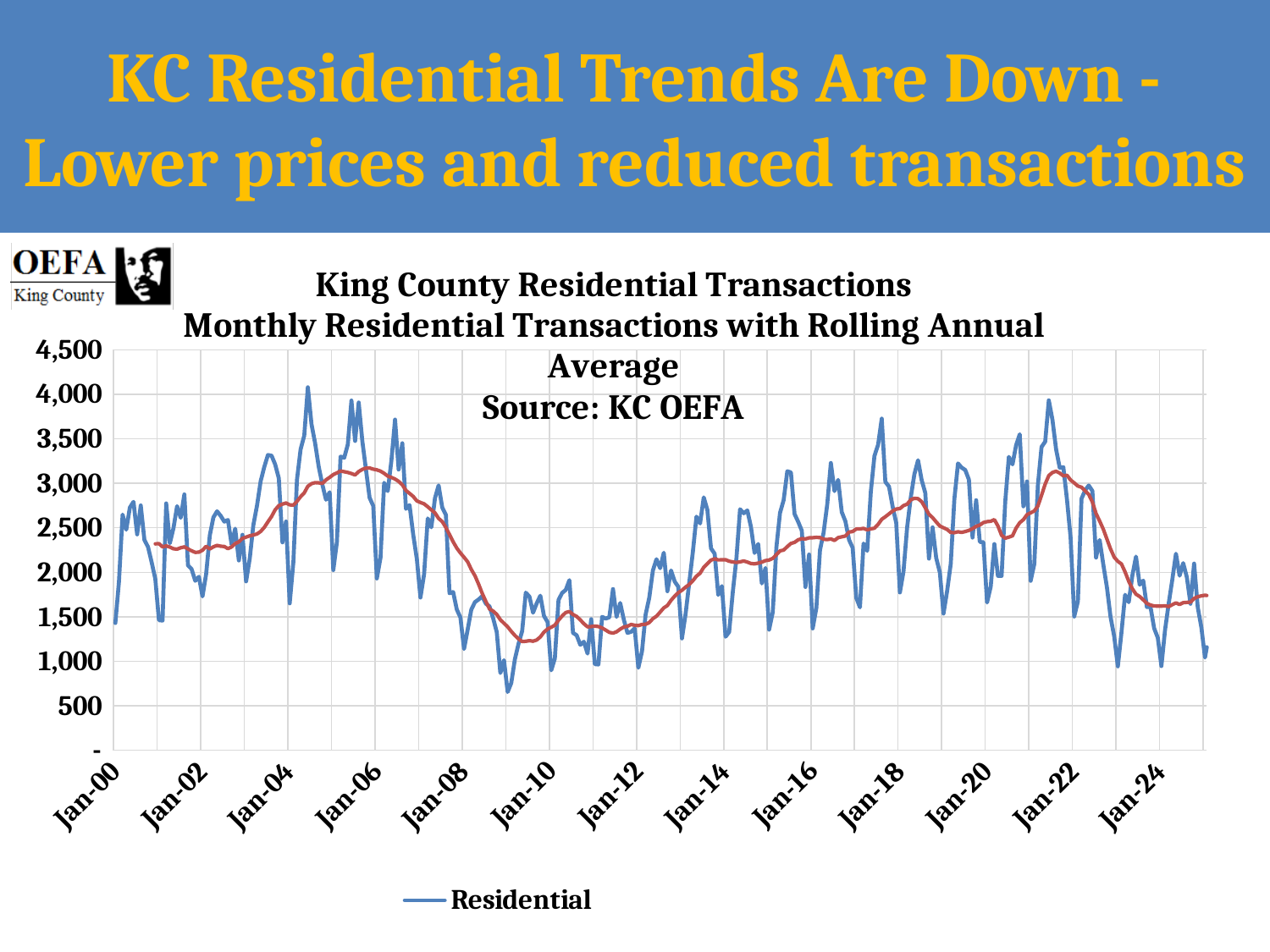
What source is cited in the chart title? KC OEFA Is the peak of the blue monthly line near Jan-22 greater or less than 3,500? greater Is the final value of the blue monthly line at the right end of the chart greater or less than 1,500? less What kind of chart is shown on the slide? Line chart Is the red rolling annual average line around Jan-06 greater or less than 3,000? greater How many series does the chart's legend list? 1 Do the values of the red rolling annual average line rise or fall between Jan-22 and Jan-24? fall How many year labels are shown along the x axis? 13 What is the name of the series listed in the legend? Residential Do the values of the red rolling annual average line rise or fall between Jan-12 and Jan-18? rise